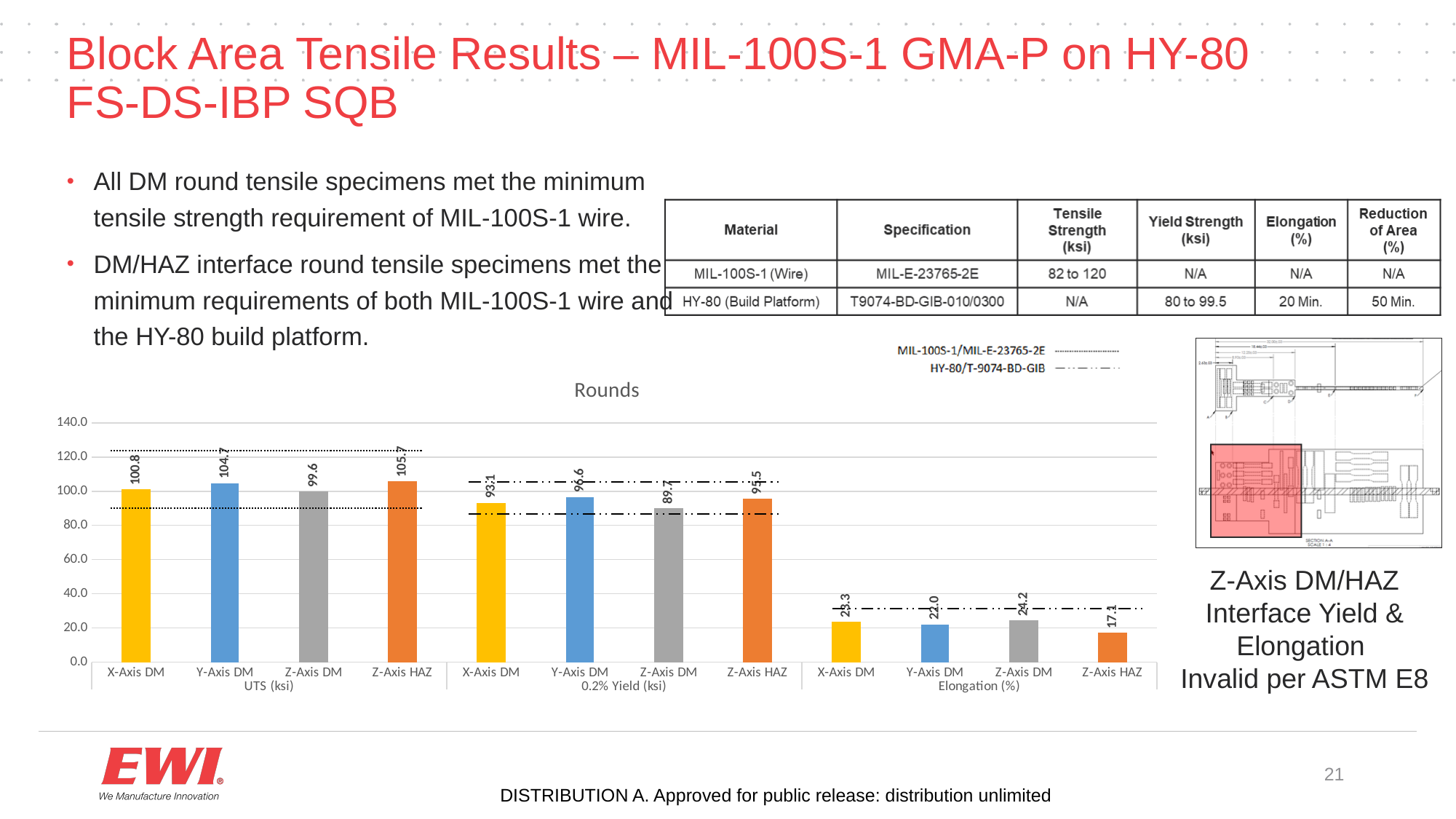
In the Rounds chart, which specimen has the lowest 0.2% Yield (ksi)? Z-Axis DM In the Rounds chart, what is the 0.2% Yield (ksi) value for Z-Axis DM? 89.7 In the Rounds chart, what is the UTS (ksi) value for Y-Axis DM? 104.7 In the Rounds chart, which has a higher 0.2% Yield (ksi): X-Axis DM or Y-Axis DM? Y-Axis DM In the Rounds chart, is the Elongation (%) value for Z-Axis DM greater or less than 20.0? greater What type of chart is the Rounds chart? Bar chart In the Rounds chart, which specimen has the highest UTS (ksi)? Z-Axis HAZ In the Rounds chart, what is the difference between the UTS (ksi) of Z-Axis HAZ and Z-Axis DM? 6.1 In the Rounds chart, what is the Elongation (%) value for Z-Axis HAZ? 17.1 What is the title of the chart on the slide? Rounds In the Rounds chart, which specimen has the lowest Elongation (%)? Z-Axis HAZ In the Rounds chart, how many bars are plotted in the UTS (ksi) group? 4